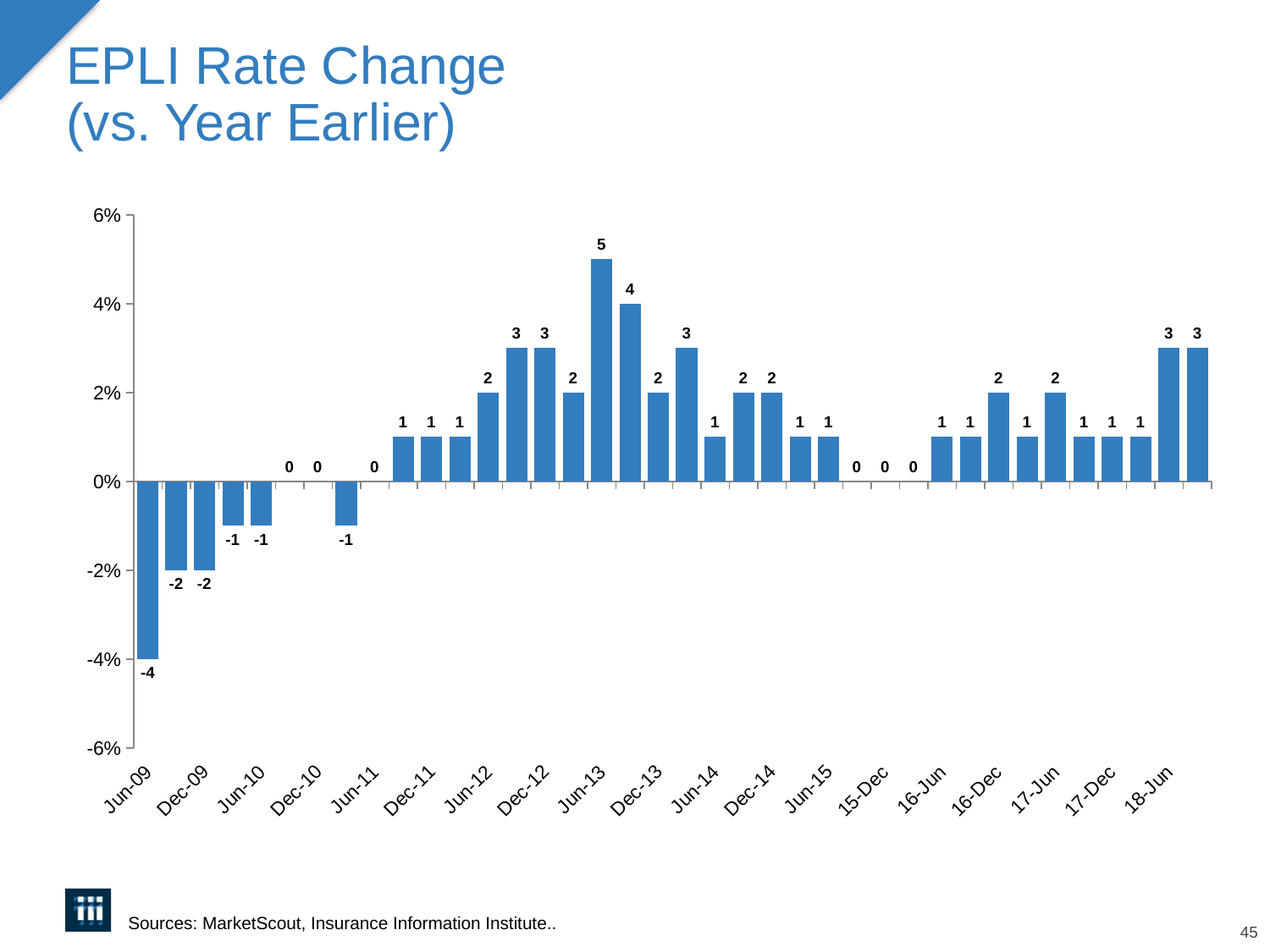
Which labeled period has the lowest EPLI rate change? Jun-09 What is the difference between the EPLI rate change for Jun-13 and Dec-13? 3 What is the EPLI rate change for Jun-13? 5 Which is larger, the EPLI rate change for Dec-09 or for Dec-14? Dec-14 What is the EPLI rate change for Jun-09? -4 Which labeled period has the highest EPLI rate change? Jun-13 What is the EPLI rate change for 15-Dec? 0 What kind of chart is shown on the slide? Bar chart Is the EPLI rate change for Jun-13 greater or less than 4%? greater What is the title of the chart? EPLI Rate Change (vs. Year Earlier) Do the EPLI rate change values rise or fall from Jun-09 to Jun-13? Rise What is the EPLI rate change for Dec-12? 3